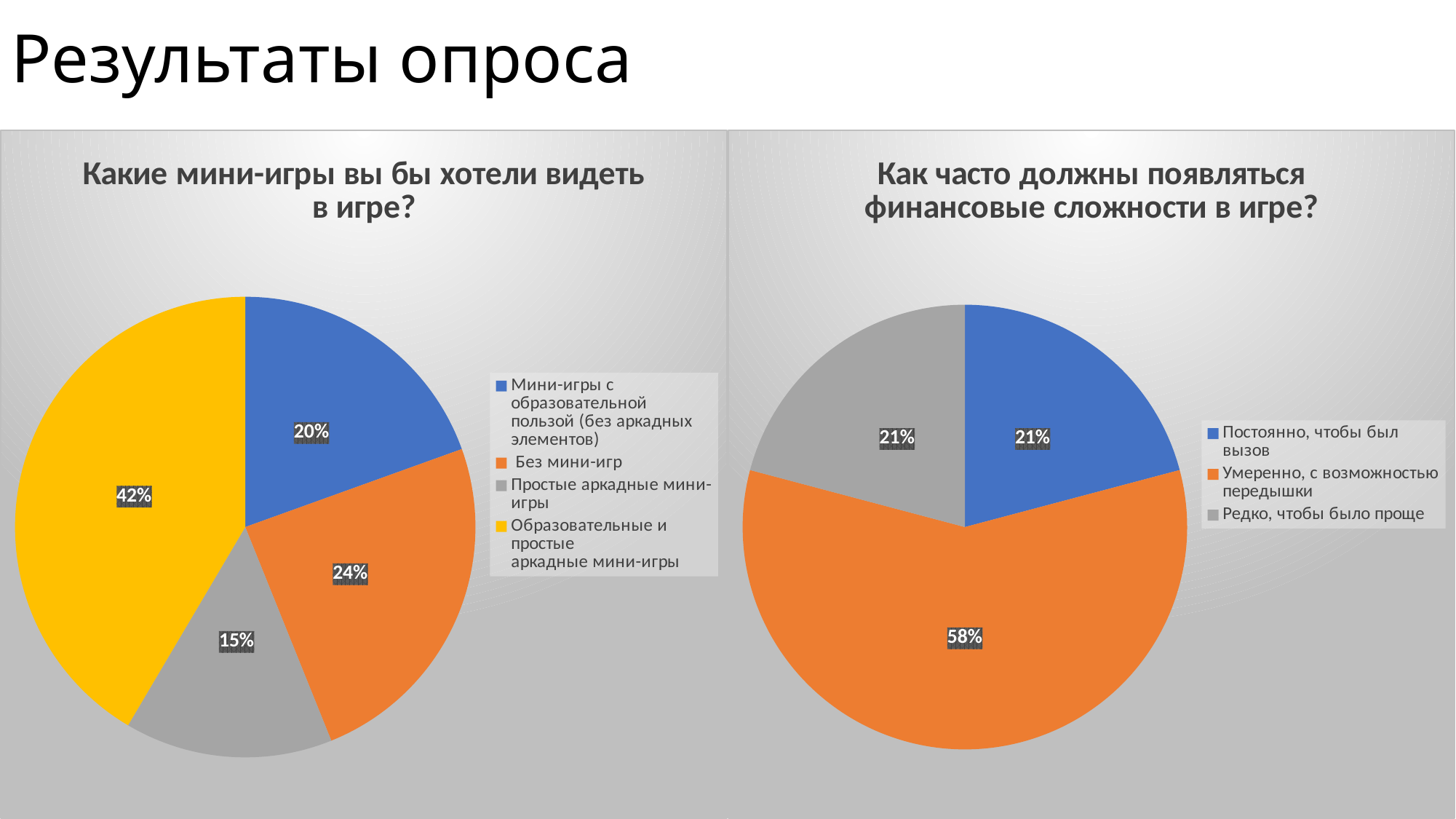
In the left chart 'Какие мини-игры вы бы хотели видеть в игре?', which category has the largest slice? Образовательные и простые аркадные мини-игры In the right chart 'Как часто должны появляться финансовые сложности в игре?', which category has the largest slice? Умеренно, с возможностью передышки In the left chart 'Какие мини-игры вы бы хотели видеть в игре?', what colour is the slice for 'Без мини-игр'? Orange In the left chart 'Какие мини-игры вы бы хотели видеть в игре?', what share is labelled for 'Простые аркадные мини-игры'? 15% In the left chart 'Какие мини-игры вы бы хотели видеть в игре?', which category has the smallest slice? Простые аркадные мини-игры What type of chart is the right chart 'Как часто должны появляться финансовые сложности в игре?'? Pie chart In the left chart 'Какие мини-игры вы бы хотели видеть в игре?', what is the difference in percentage points between 'Образовательные и простые аркадные мини-игры' and 'Мини-игры с образовательной пользой (без аркадных элементов)'? 22 percentage points In the left chart 'Какие мини-игры вы бы хотели видеть в игре?', what share is labelled for 'Без мини-игр'? 24% In the right chart 'Как часто должны появляться финансовые сложности в игре?', what share is labelled for 'Редко, чтобы было проще'? 21% In the right chart 'Как часто должны появляться финансовые сложности в игре?', what share is labelled for 'Умеренно, с возможностью передышки'? 58% In the left chart 'Какие мини-игры вы бы хотели видеть в игре?', how many categories does the legend list? 4 In the right chart 'Как часто должны появляться финансовые сложности в игре?', how many categories does the legend list? 3